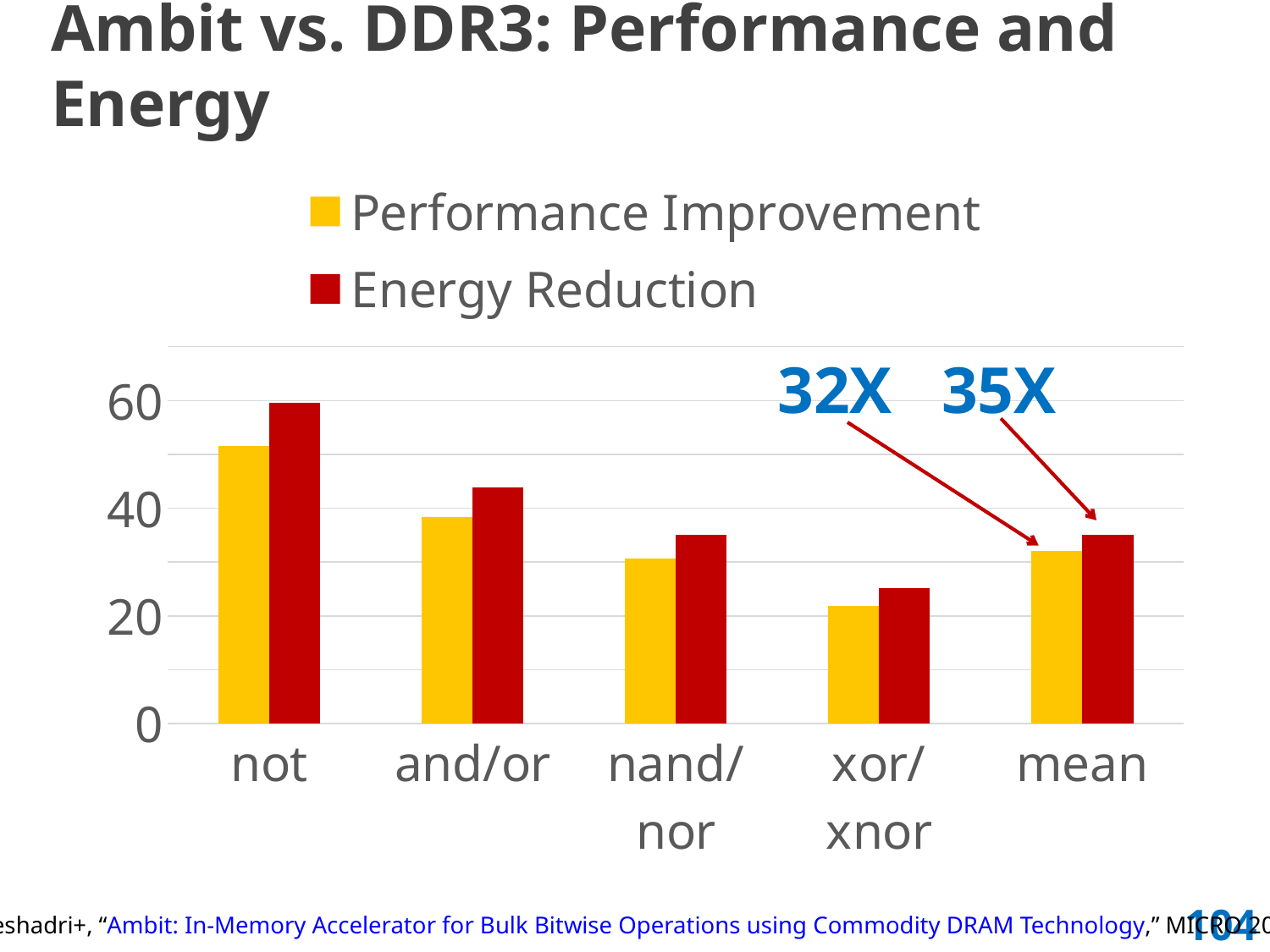
Is the Energy Reduction value for xor/xnor greater or less than 40? less For the not operation, which is larger: Performance Improvement or Energy Reduction? Energy Reduction Which colour represents Energy Reduction in the legend? red How many categories are shown on the x axis? 5 Do the Performance Improvement values rise or fall from not to xor/xnor along the x axis? fall Is the Performance Improvement value for not greater or less than 40? greater How many series does the legend list? 2 Which operation has the lowest Performance Improvement? xor/xnor Which operation has the highest Energy Reduction? not What is the Energy Reduction value for the mean category? 35X What is the Performance Improvement value for the mean category? 32X What type of chart is shown on the slide? bar chart